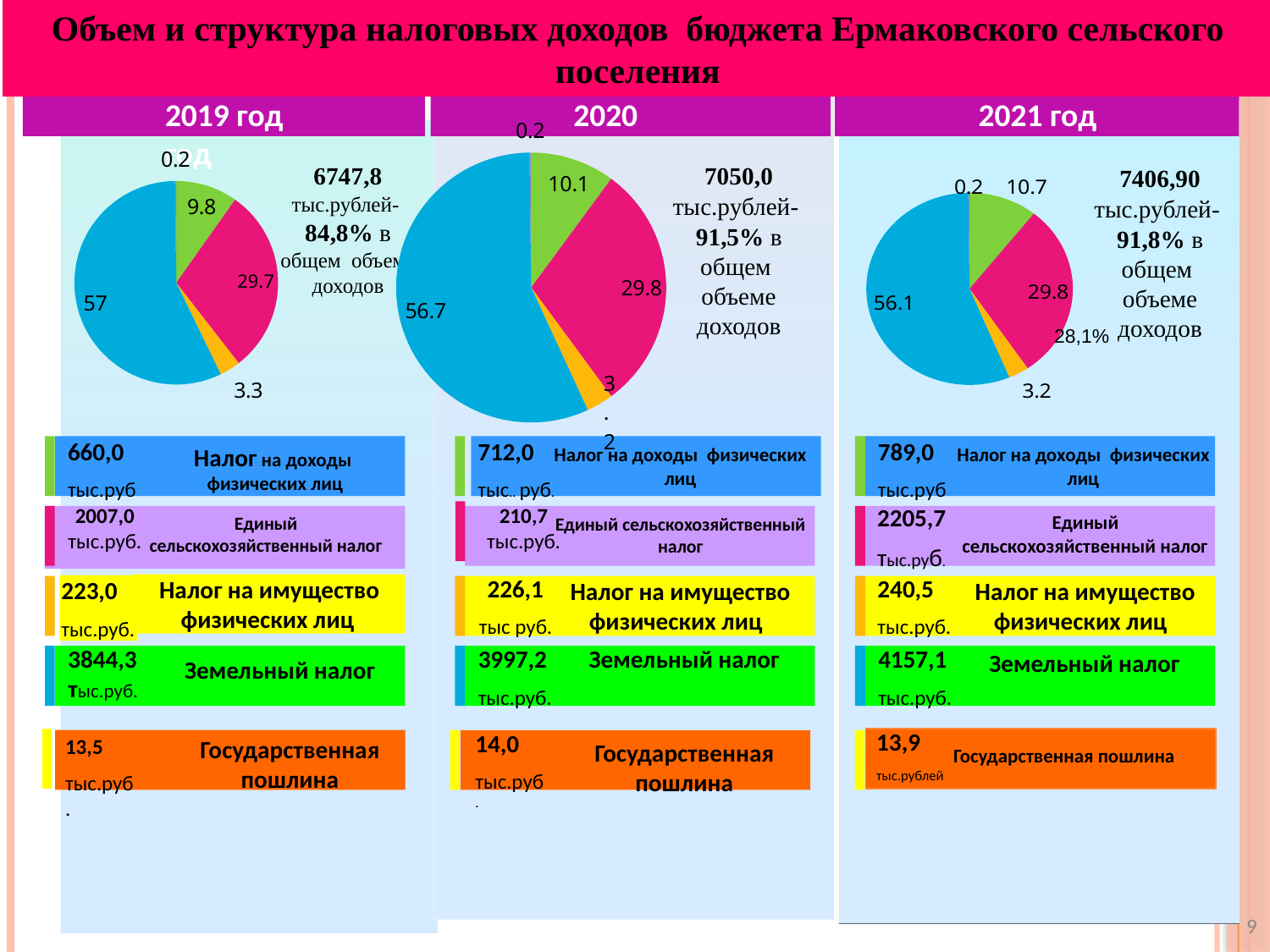
What share of total income is printed next to the 2019 год pie chart? 84,8% In the 2021 год pie chart, what is the value of the largest slice? 56.1 How many pie charts are on the slide? 3 In the 2019 год pie chart, what is the value of the smallest slice? 0.2 What kind of chart is used for each year on the slide? pie chart In the 2019 год pie chart, what is the difference between the largest slice (57) and the pink slice (29.7)? 27.3 In the 2019 год pie chart, how many slices are there? 5 In the 2020 pie chart, what is the value of the largest slice? 56.7 Which is larger: the largest slice of the 2019 год pie chart or the largest slice of the 2021 год pie chart? 2019 год (57) In the 2020 pie chart, what is the value of the green slice? 10.1 In the 2019 год pie chart, what is the value of the largest slice? 57 What total amount in тыс.рублей is printed next to the 2021 год pie chart? 7406,90